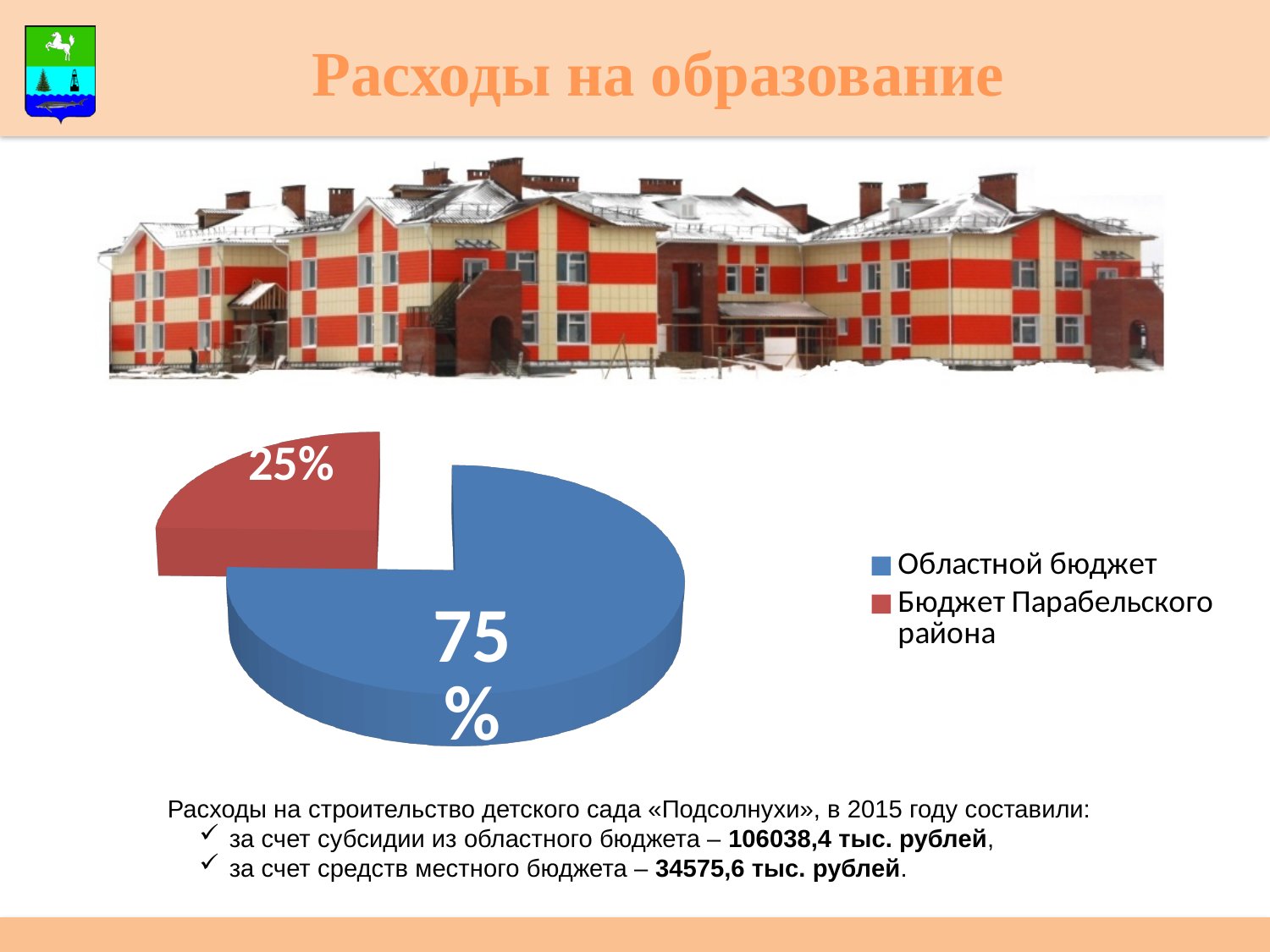
What is the difference in percentage points between the Областной бюджет slice and the Бюджет Парабельского района slice? 50 How many entries does the legend list? 2 Which is larger, the share for Областной бюджет or for Бюджет Парабельского района? Областной бюджет Which slice of the pie is the largest? Областной бюджет Which slice of the pie is the smallest? Бюджет Парабельского района What share of the pie does Областной бюджет represent? 75% What colour is the slice for Бюджет Парабельского района? red Is the share for Областной бюджет greater or less than 50%? greater What kind of chart is shown on the slide? pie chart What colour is the slice for Областной бюджет? blue What share of the pie does Бюджет Парабельского района represent? 25% How many slices does the pie chart have? 2